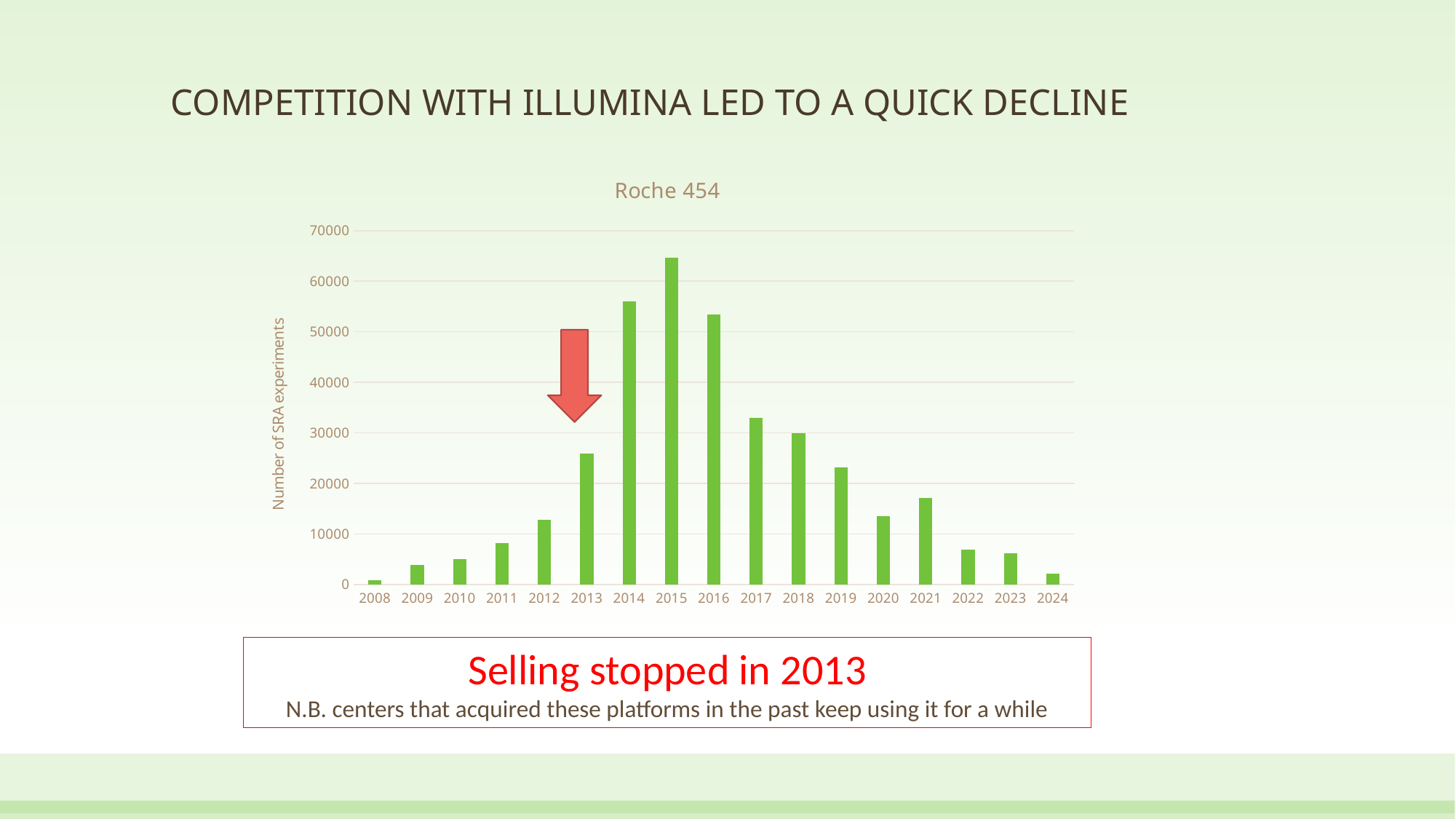
Which year has the lowest number of SRA experiments? 2008 How many years are shown on the x axis? 17 Is the value for 2013 greater or less than 30000? less Is the value for 2014 greater or less than 50000? greater Which year has a higher value, 2020 or 2021? 2021 Is the value for 2024 greater or less than 10000? less What is the title of the chart? Roche 454 Do the values rise or fall from 2015 to 2024? fall Which year has the highest number of SRA experiments? 2015 What kind of chart is shown on the slide? bar chart What is the label of the vertical axis? Number of SRA experiments